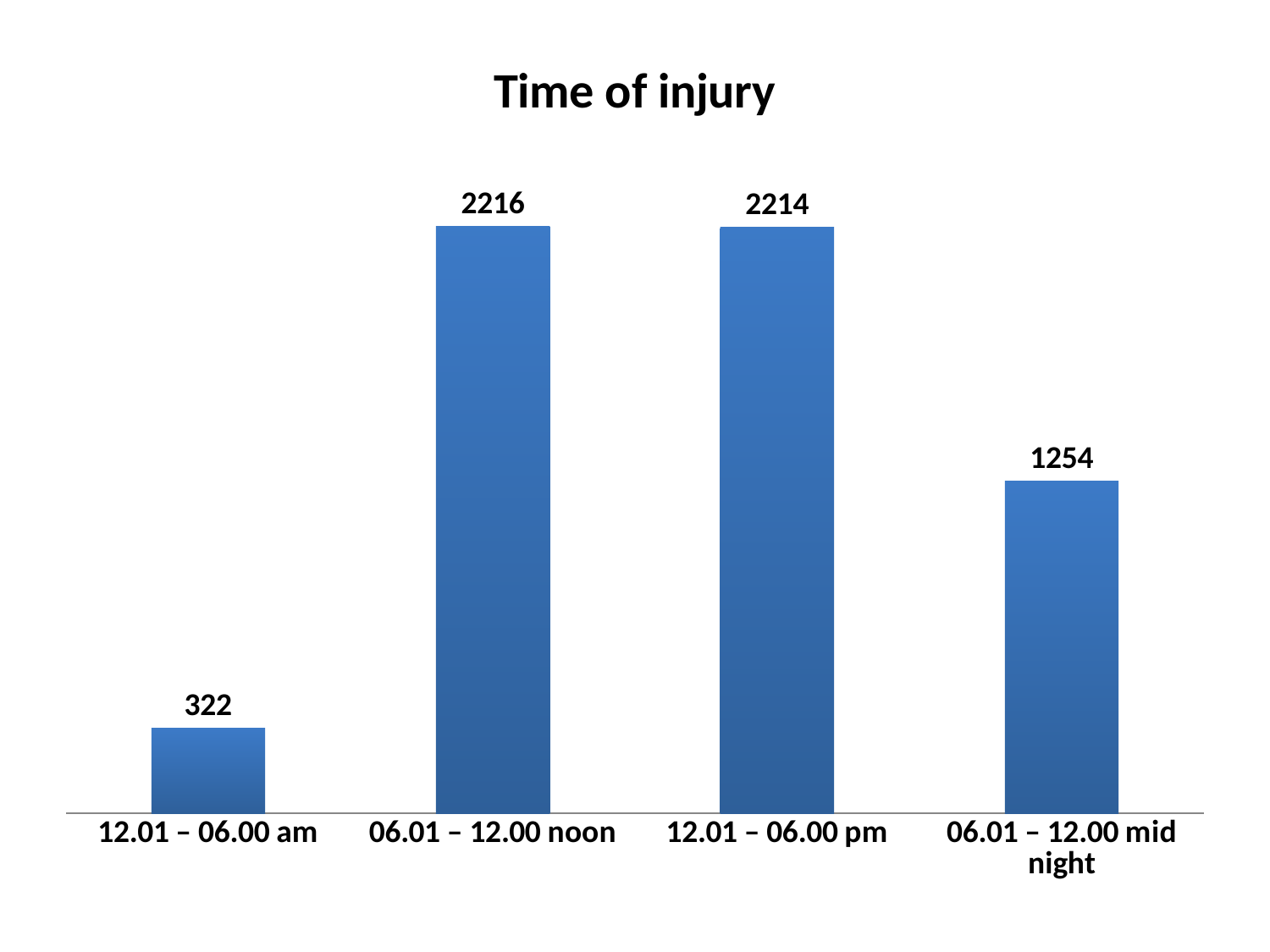
How many time periods are shown on the chart? 4 What is the value for 12.01 – 06.00 pm? 2214 Does the value rise or fall from 12.01 – 06.00 pm to 06.01 – 12.00 mid night? Fall What kind of chart is this? Bar chart What is the value for 06.01 – 12.00 mid night? 1254 Which time period has the lowest value? 12.01 – 06.00 am What is the value for 12.01 – 06.00 am? 322 What is the difference between the values for 12.01 – 06.00 pm and 06.01 – 12.00 mid night? 960 What is the title of the chart? Time of injury Which is larger, the value for 06.01 – 12.00 mid night or the value for 12.01 – 06.00 am? 06.01 – 12.00 mid night What is the value for 06.01 – 12.00 noon? 2216 What is the difference between the values for 06.01 – 12.00 noon and 12.01 – 06.00 am? 1894